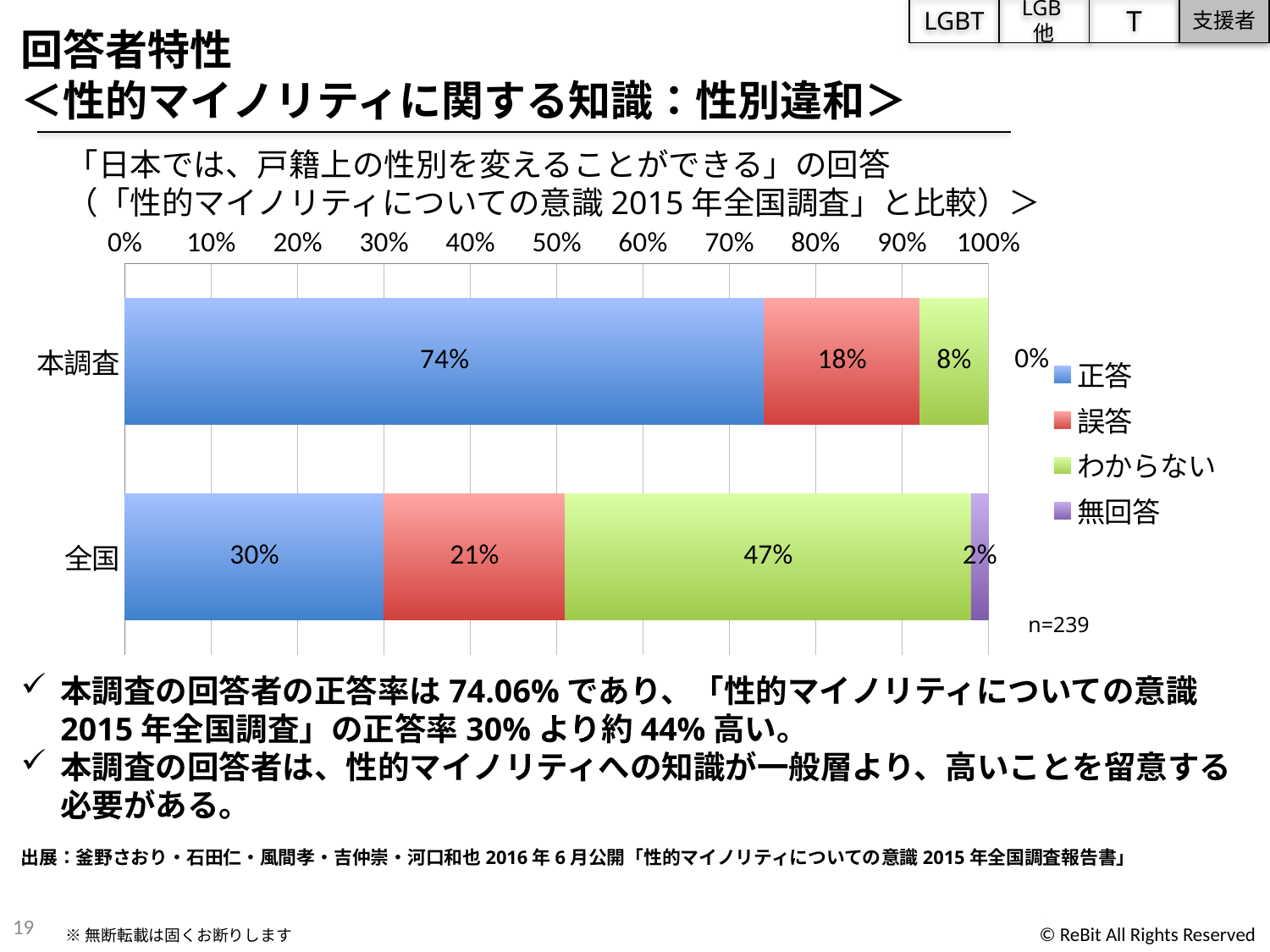
What is the 無回答 value for 全国? 2% What is the sample size (n) shown on the chart? n=239 What is the 正答 value for 全国? 30% How many series does the legend list? 4 What is the 誤答 value for 全国? 21% Which series has the highest value for 全国? わからない What is the 正答 value for 本調査? 74% What is the difference between the 正答 values for 本調査 and 全国? 44% What kind of chart is shown on the slide? stacked bar chart Which category has the larger わからない value, 本調査 or 全国? 全国 How many categories are shown on the chart? 2 What is the わからない value for 本調査? 8%